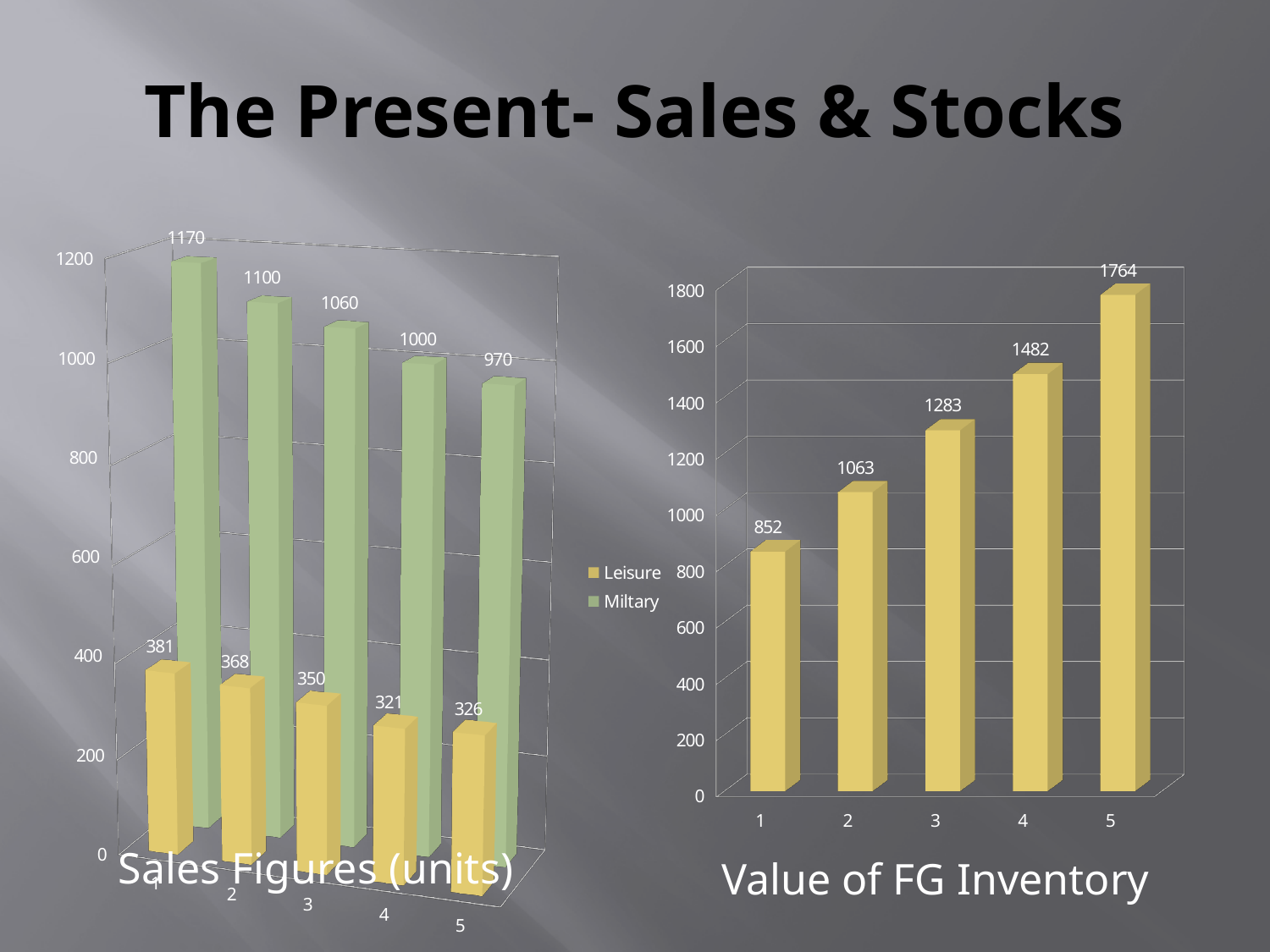
In the Sales Figures (units) chart, which category has the highest Leisure value? 1 In the Sales Figures (units) chart, do the Miltary values rise or fall from category 1 to category 5? fall In the Sales Figures (units) chart, what is the Leisure value for category 4? 321 In the Value of FG Inventory chart, how many categories are shown on the x axis? 5 In the Sales Figures (units) chart, what is the Miltary value for category 1? 1170 In the Sales Figures (units) chart, how many series does the legend list? 2 What kind of chart is the Value of FG Inventory chart? bar chart In the Value of FG Inventory chart, which category has the highest value? 5 In the Sales Figures (units) chart, which category has the lowest Miltary value? 5 In the Value of FG Inventory chart, what is the value for category 3? 1283 In the Sales Figures (units) chart, what is the difference between the Miltary and Leisure values for category 3? 710 In the Value of FG Inventory chart, what is the difference between the values for category 5 and category 1? 912